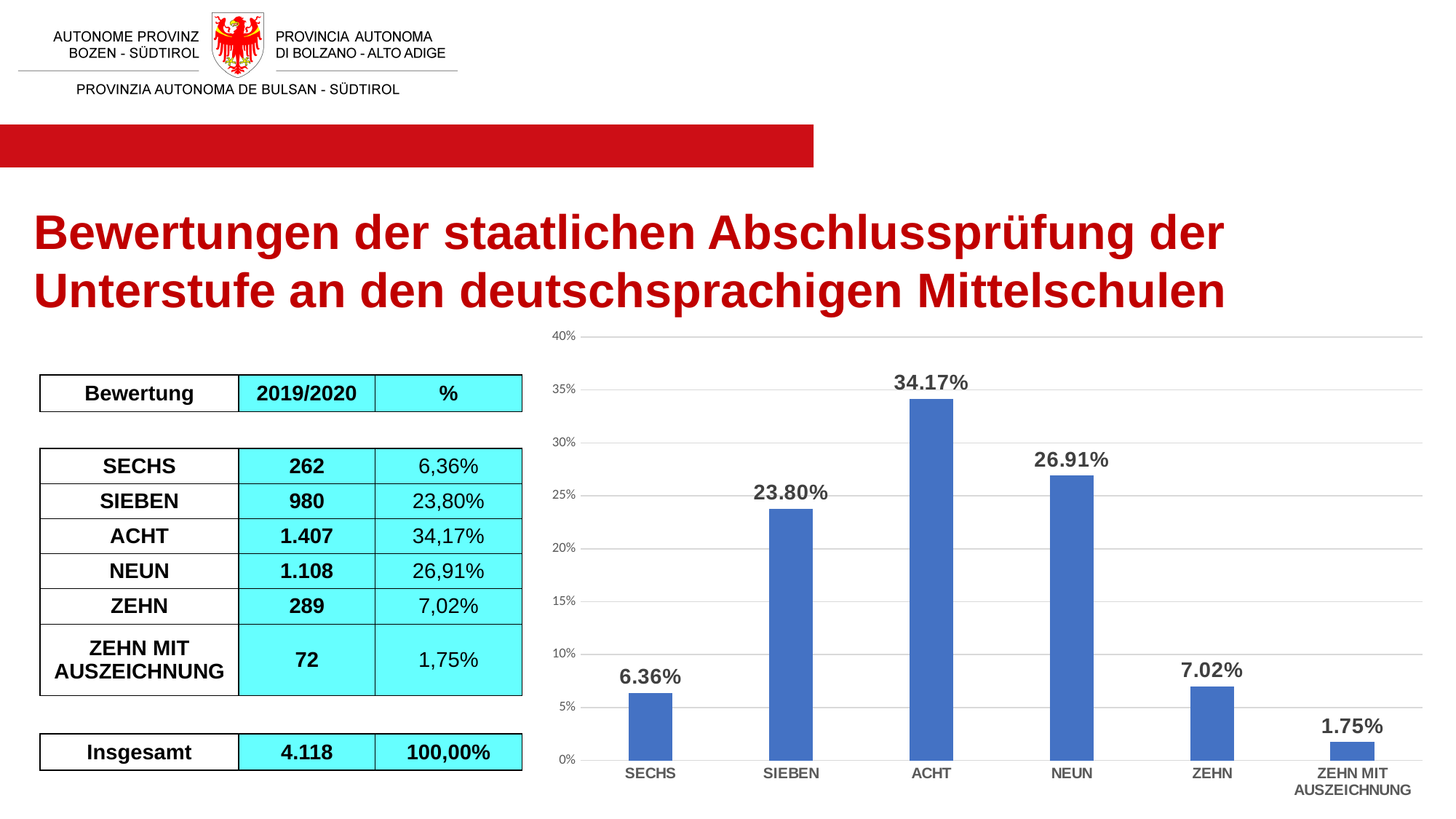
What is the value shown for SECHS in the chart? 6.36% What kind of chart is shown on the slide? bar chart How many categories are shown on the x axis of the chart? 6 What is the highest value labelled on the y axis of the chart? 40% Which category has the highest value in the chart? ACHT What is the difference between the values for ZEHN and SECHS in the chart? 0.66% Which category has the lowest value in the chart? ZEHN MIT AUSZEICHNUNG Is the value for SIEBEN in the chart greater or less than 20%? greater What is the difference between the values for ACHT and NEUN in the chart? 7.26% Which is larger in the chart, the value for SIEBEN or the value for NEUN? NEUN What is the value shown for ACHT in the chart? 34.17% What is the value shown for ZEHN MIT AUSZEICHNUNG in the chart? 1.75%